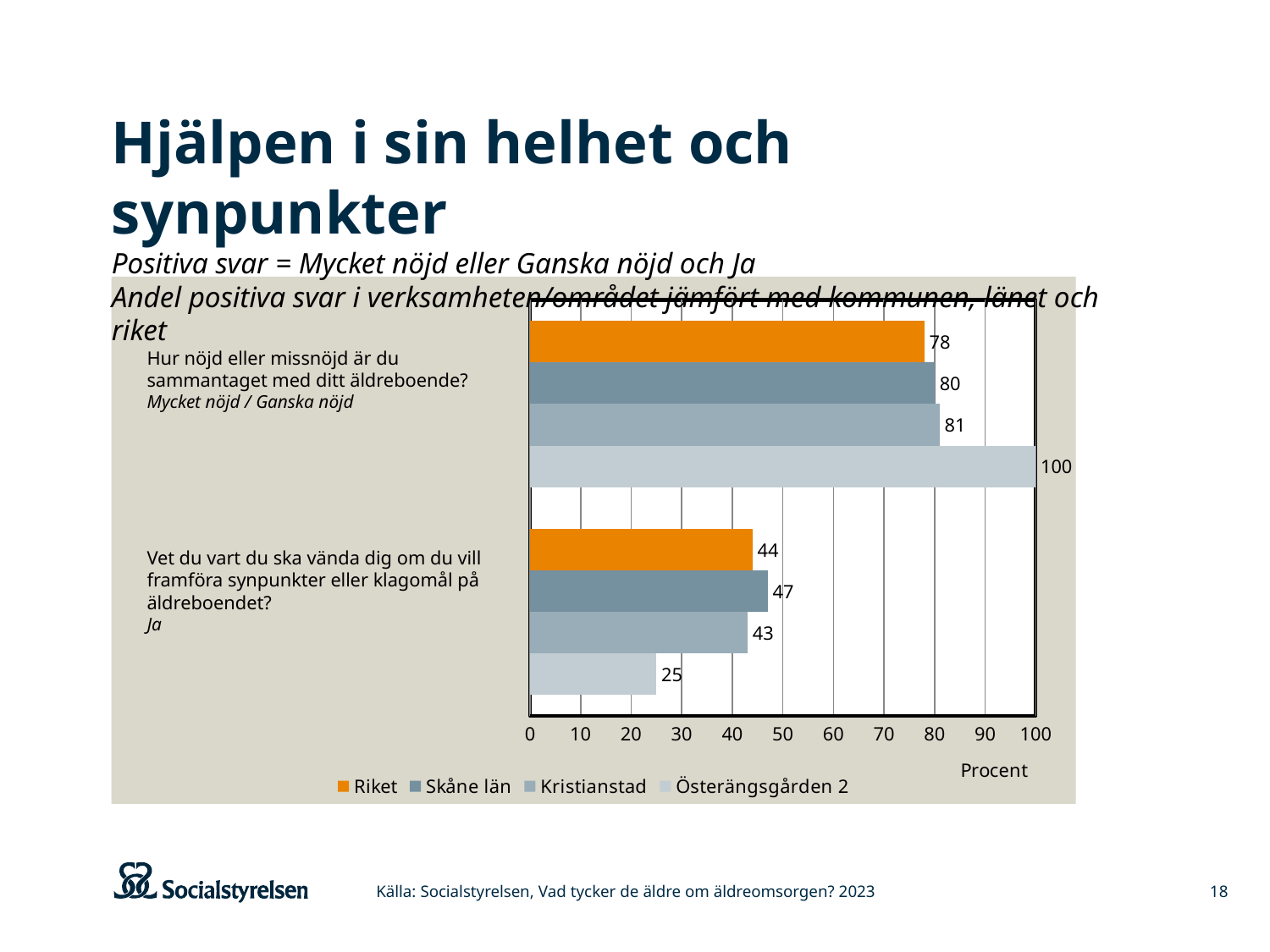
What is the difference between the Skåne län value and the Österängsgården 2 value on the question "Vet du vart du ska vända dig om du vill framföra synpunkter eller klagomål på äldreboendet?"? 22 How many series does the legend list? 4 What is the value for Kristianstad on the question "Hur nöjd eller missnöjd är du sammantaget med ditt äldreboende?"? 81 What is the value for Österängsgården 2 on the question "Hur nöjd eller missnöjd är du sammantaget med ditt äldreboende?"? 100 Which series has the highest value on the question "Hur nöjd eller missnöjd är du sammantaget med ditt äldreboende?"? Österängsgården 2 Which is larger on the question "Vet du vart du ska vända dig om du vill framföra synpunkter eller klagomål på äldreboendet?": Riket or Österängsgården 2? Riket What kind of chart is shown on the slide? Bar chart What is the value for Riket on the question "Vet du vart du ska vända dig om du vill framföra synpunkter eller klagomål på äldreboendet?"? 44 Which series has the lowest value on the question "Vet du vart du ska vända dig om du vill framföra synpunkter eller klagomål på äldreboendet?"? Österängsgården 2 What is the label of the x axis of the chart? Procent What is the value for Skåne län on the question "Vet du vart du ska vända dig om du vill framföra synpunkter eller klagomål på äldreboendet?"? 47 What is the difference between the Österängsgården 2 value and the Riket value on the question "Hur nöjd eller missnöjd är du sammantaget med ditt äldreboende?"? 22